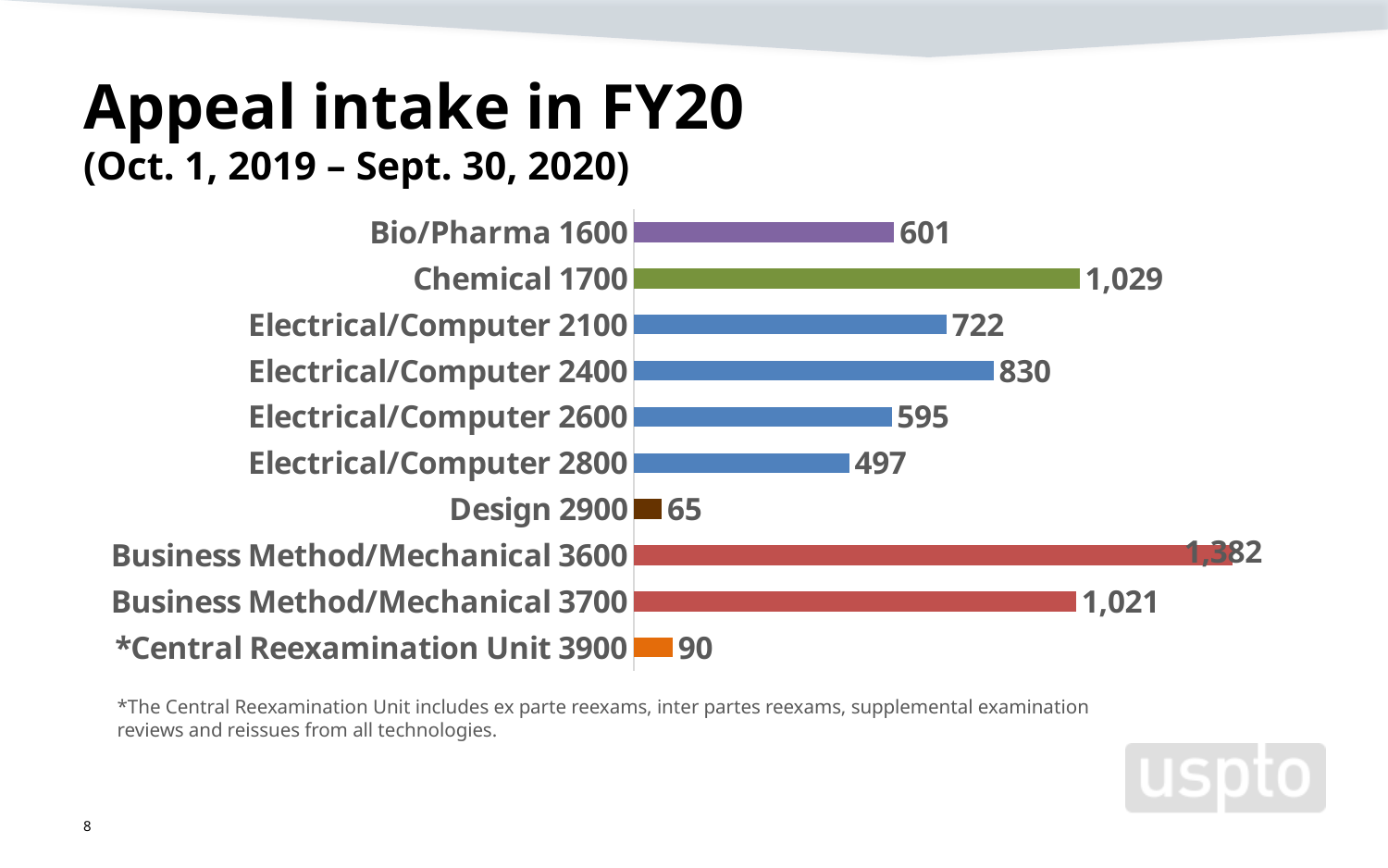
Which category has the highest appeal intake? Business Method/Mechanical 3600 How many categories are shown in the chart? 10 What is the appeal intake value for Electrical/Computer 2400? 830 Which category has the lowest appeal intake? Design 2900 What kind of chart is shown on the slide? Bar chart What is the difference between the appeal intake for Electrical/Computer 2400 and Electrical/Computer 2100? 108 What is the appeal intake value for *Central Reexamination Unit 3900? 90 What is the appeal intake value for Design 2900? 65 Which has a larger appeal intake, Bio/Pharma 1600 or Electrical/Computer 2600? Bio/Pharma 1600 What is the title of the slide containing the chart? Appeal intake in FY20 What is the appeal intake value for Chemical 1700? 1,029 What is the difference between the appeal intake for Chemical 1700 and Business Method/Mechanical 3700? 8